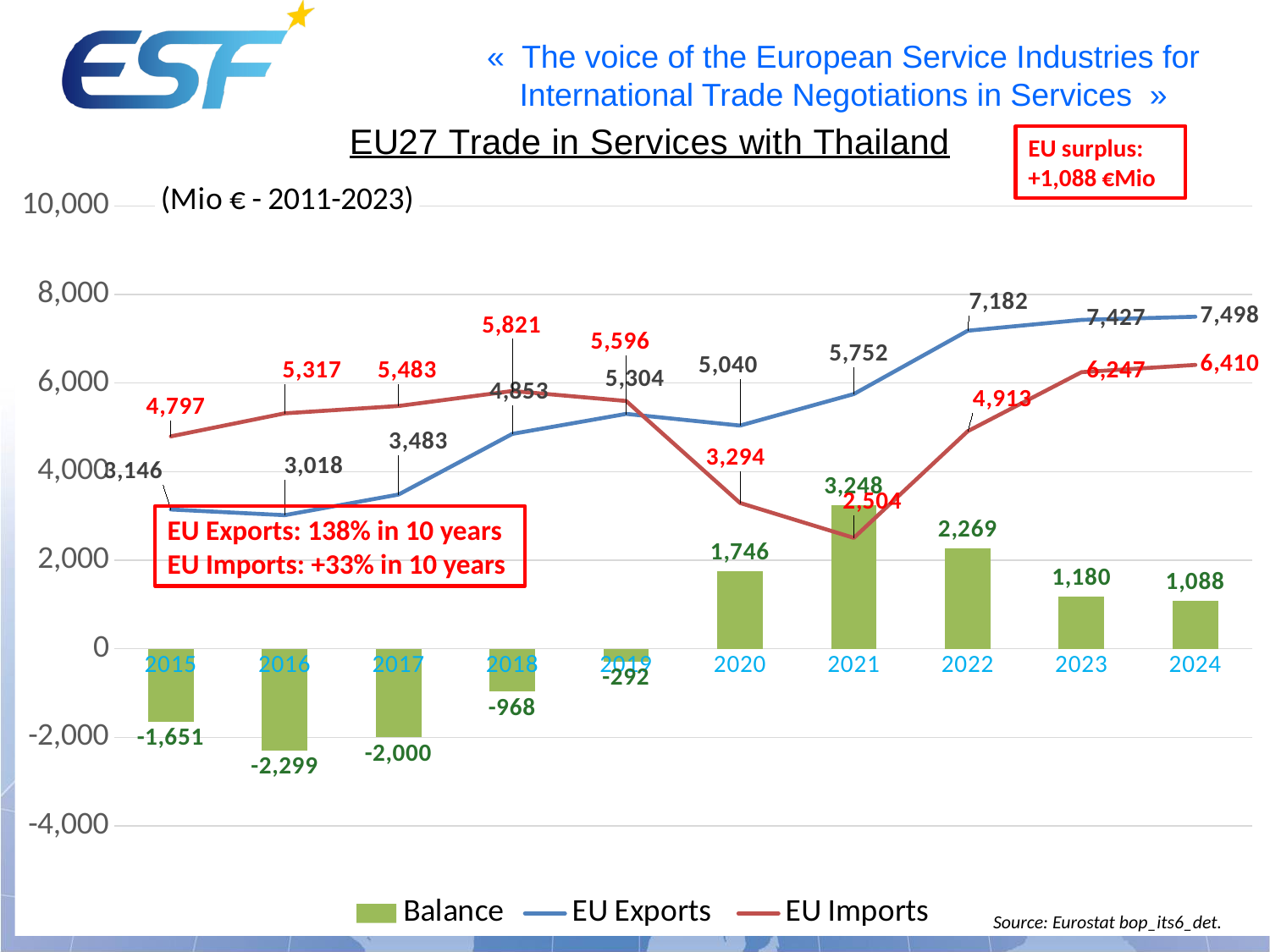
How many years are shown on the x axis? 10 Which is larger in 2017, EU Exports or EU Imports? EU Imports What is the Balance value for 2016? -2,299 In which year is EU Imports lowest? 2021 What is the value of EU Imports in 2021? 2,504 What kinds of chart are combined on this slide? Bar chart and line chart Is the value of EU Exports in 2022 greater or less than 6,000? greater How many series does the legend list? 3 What is the difference between EU Exports and EU Imports in 2024? 1,088 In which year is the Balance highest? 2021 What is the value of EU Exports in 2024? 7,498 Do EU Exports rise or fall from 2021 to 2024? Rise